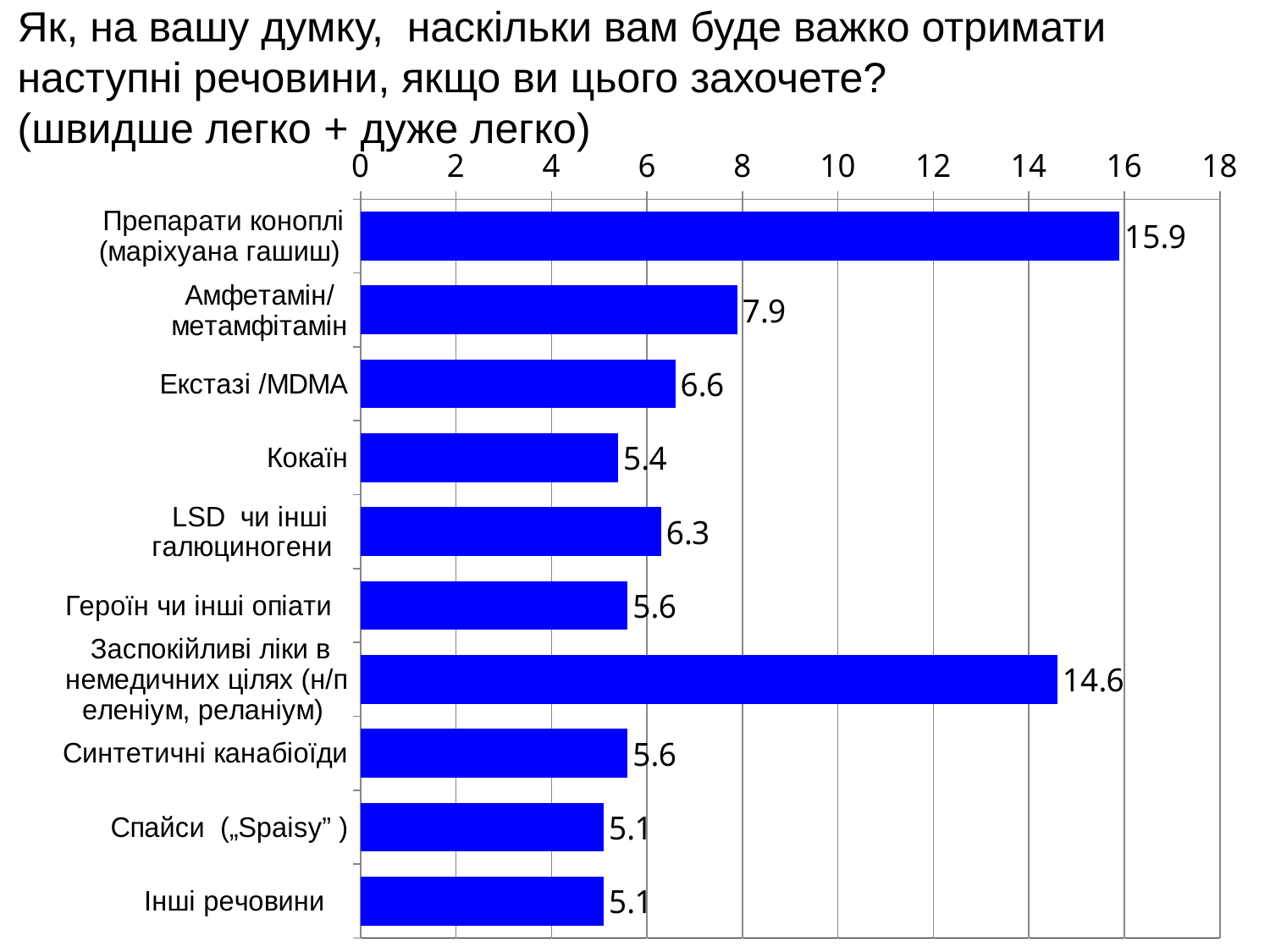
Which is larger, the value for LSD чи інші галюциногени or the value for Кокаїн? LSD чи інші галюциногени How many categories are shown in the chart? 10 What is the value for Спайси („Spaisy”)? 5.1 What is the difference between the values for Препарати коноплі (маріхуана гашиш) and Амфетамін/метамфітамін? 8.0 Is the value for Амфетамін/метамфітамін greater or less than 8? less What kind of chart is shown on the slide? bar chart What is the value for Заспокійливі ліки в немедичних цілях (н/п еленіум, реланіум)? 14.6 What is the value for Екстазі /MDMA? 6.6 Which category has the highest value? Препарати коноплі (маріхуана гашиш) What is the value for Препарати коноплі (маріхуана гашиш)? 15.9 What is the value for Кокаїн? 5.4 What is the difference between the values for Заспокійливі ліки в немедичних цілях and Героїн чи інші опіати? 9.0